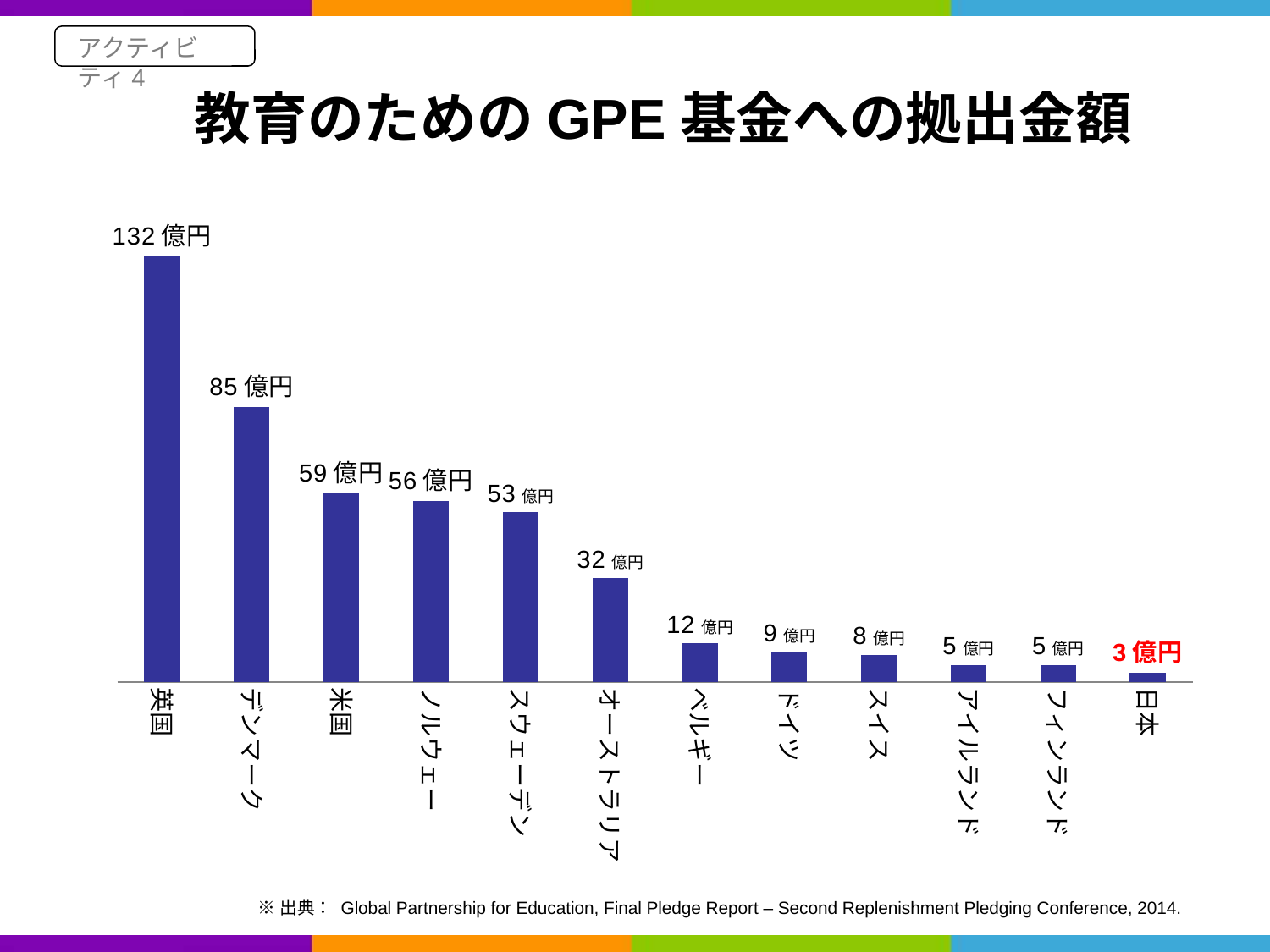
Which is larger, the value for ベルギー or the value for ドイツ? ベルギー How many countries are shown in the chart? 12 What is the value for オーストラリア (Australia) in the chart? 32 億円 What kind of chart is shown on the slide? Bar chart What is the value for 日本 (Japan) in the chart? 3 億円 Which country has the lowest contribution in the chart? 日本 What is the difference between the values for 米国 and 日本? 56 億円 What is the value for 英国 (UK) in the chart? 132 億円 Do the values rise or fall from left to right across the chart? Fall Which country has the highest contribution in the chart? 英国 What is the difference between the values for 英国 and デンマーク? 47 億円 What is the title of the chart on the slide? 教育のための GPE 基金への拠出金額